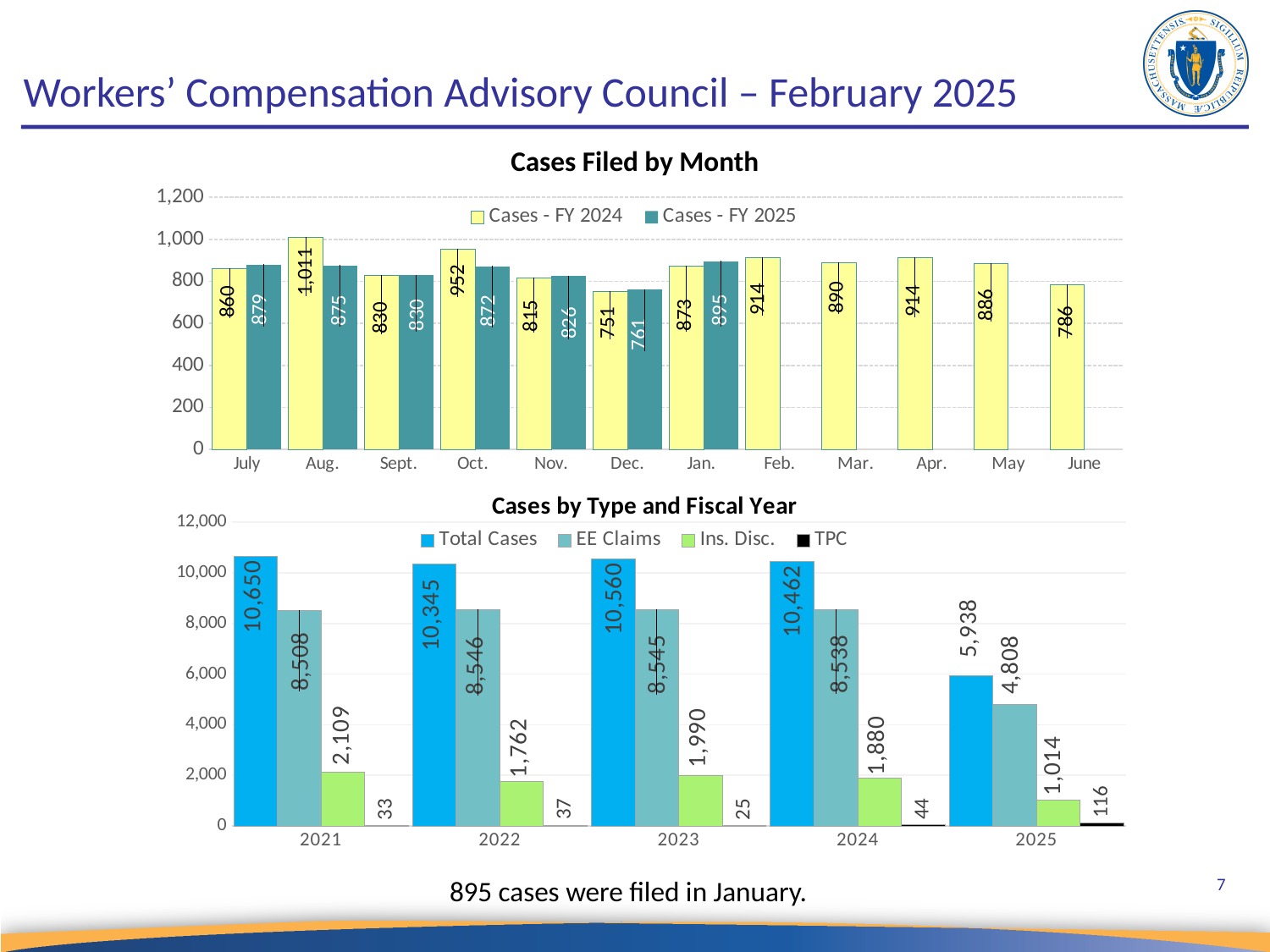
In the 'Cases Filed by Month' chart, which is larger in October: Cases - FY 2024 or Cases - FY 2025? Cases - FY 2024 In the 'Cases Filed by Month' chart, what is the difference between Cases - FY 2025 and Cases - FY 2024 in July? 19 What kind of chart is 'Cases by Type and Fiscal Year'? Bar chart In the 'Cases by Type and Fiscal Year' chart, what is the value for EE Claims in 2023? 8,545 In the 'Cases by Type and Fiscal Year' chart, how many fiscal years are shown on the x axis? 5 In the 'Cases Filed by Month' chart, what is the value for Cases - FY 2024 in August? 1,011 In the 'Cases Filed by Month' chart, how many series does the legend list? 2 In the 'Cases Filed by Month' chart, what is the value for Cases - FY 2025 in January? 895 In the 'Cases by Type and Fiscal Year' chart, which year has the highest value for TPC? 2025 In the 'Cases by Type and Fiscal Year' chart, which year has the highest value for Total Cases? 2021 In the 'Cases by Type and Fiscal Year' chart, what is the difference between Ins. Disc. in 2021 and Ins. Disc. in 2022? 347 In the 'Cases Filed by Month' chart, which month has the lowest value for Cases - FY 2024? Dec.